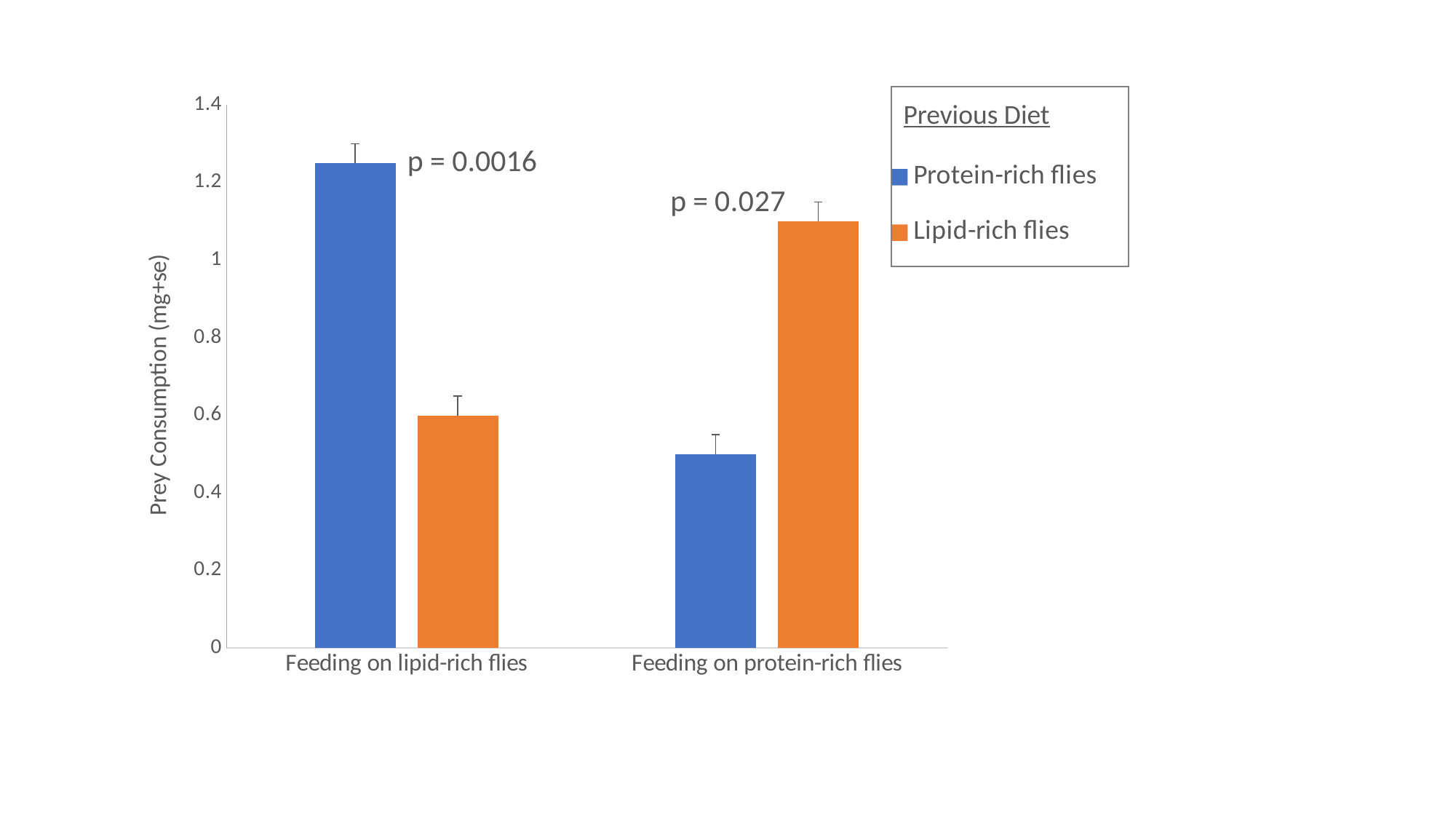
How many series does the legend list? 2 Is the value for Protein-rich flies when feeding on lipid-rich flies greater or less than 1.2? greater What kind of chart is shown on the slide? bar chart Is the value for Lipid-rich flies when feeding on lipid-rich flies greater or less than 0.8? less What p-value is shown for the Feeding on lipid-rich flies category? p = 0.0016 Which series has the larger value when feeding on protein-rich flies? Lipid-rich flies Is the value for Lipid-rich flies when feeding on protein-rich flies greater or less than 1? greater Which series has the larger value when feeding on lipid-rich flies? Protein-rich flies How many categories are shown on the x axis? 2 What is the title of the legend? Previous Diet What is the y-axis label? Prey Consumption (mg+se)